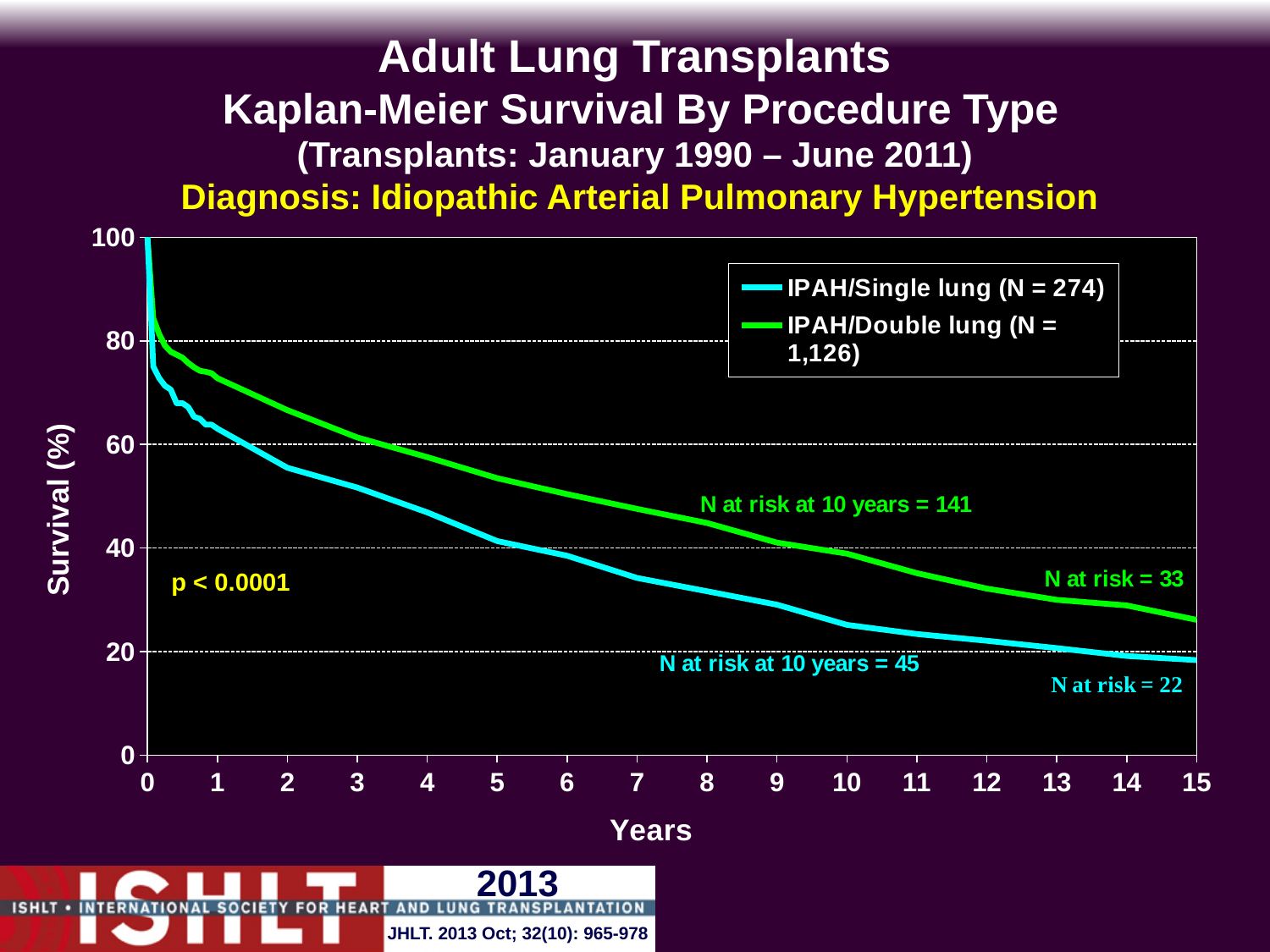
Is the survival for IPAH/Double lung at 15 years greater or less than 20? greater What is the N at risk at 10 years for the IPAH/Double lung group? 141 Is the survival for IPAH/Single lung at 10 years greater or less than 40? less What p-value is shown on the chart? p < 0.0001 Do the survival curves rise or fall as years increase? Fall What is the N for the IPAH/Single lung group shown in the legend? 274 Which group has higher survival at 10 years, IPAH/Single lung or IPAH/Double lung? IPAH/Double lung What is the N for the IPAH/Double lung group shown in the legend? 1,126 What kind of chart is shown on the slide? Line chart How many series does the legend list? 2 What is the N at risk at 10 years for the IPAH/Single lung group? 45 What is the difference between the N at risk at 10 years for the double lung group and the single lung group? 96